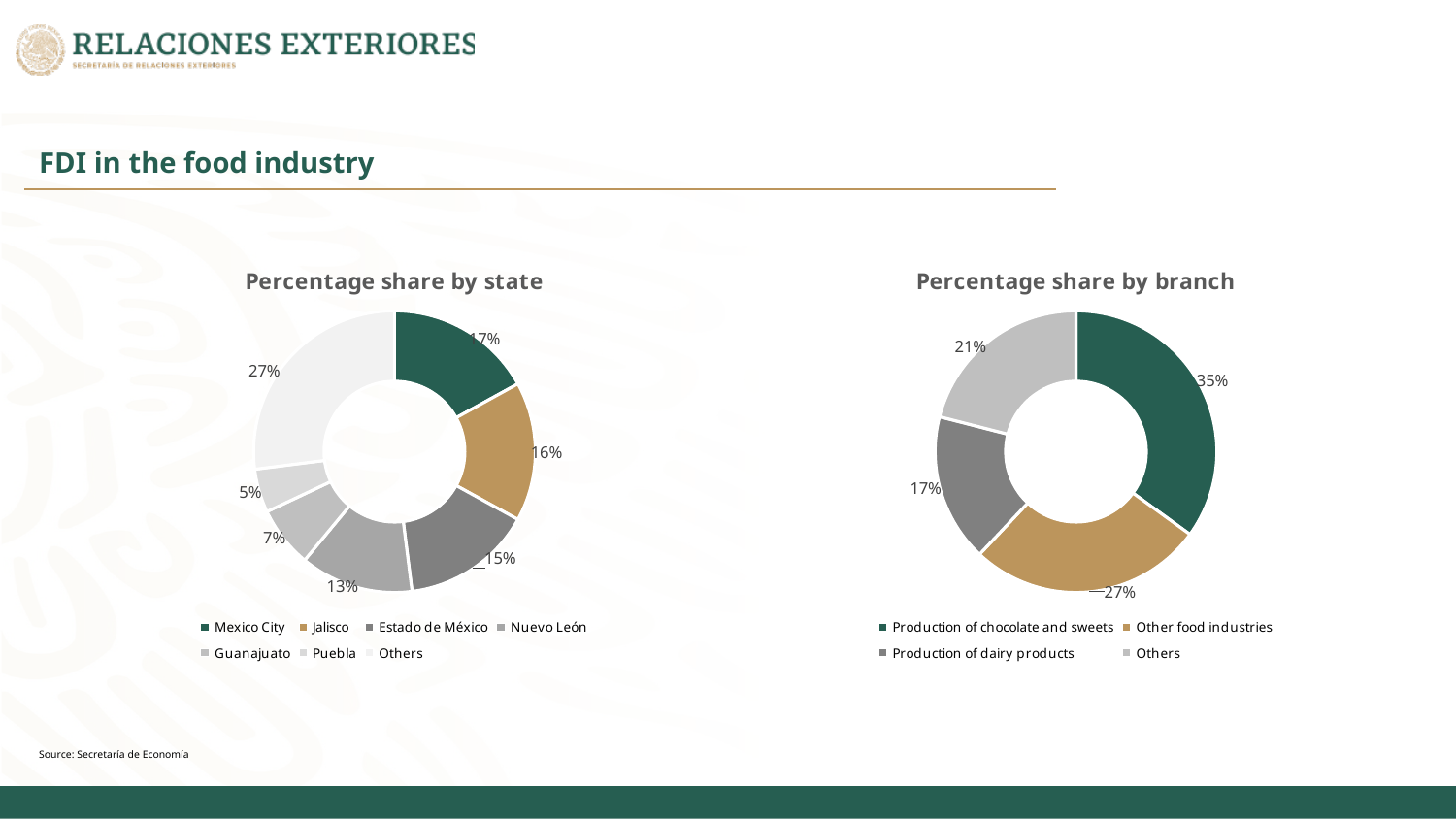
In the 'Percentage share by state' chart, what is the share for Jalisco? 16% What type of chart is 'Percentage share by branch'? Doughnut (pie) chart In the 'Percentage share by state' chart, how many categories does the legend list? 7 In the 'Percentage share by state' chart, what is the difference between the shares of Nuevo León and Guanajuato? 6% In the 'Percentage share by branch' chart, what is the share for Production of dairy products? 17% In the 'Percentage share by branch' chart, which is larger: Other food industries or Others? Other food industries In the 'Percentage share by branch' chart, what is the difference between the shares of Production of chocolate and sweets and Production of dairy products? 18% In the 'Percentage share by state' chart, which category has the smallest share? Puebla In the 'Percentage share by state' chart, what is the share for Mexico City? 17% In the 'Percentage share by state' chart, which category has the largest share? Others In the 'Percentage share by state' chart, what is the share for Puebla? 5% In the 'Percentage share by branch' chart, what is the share for Production of chocolate and sweets? 35%